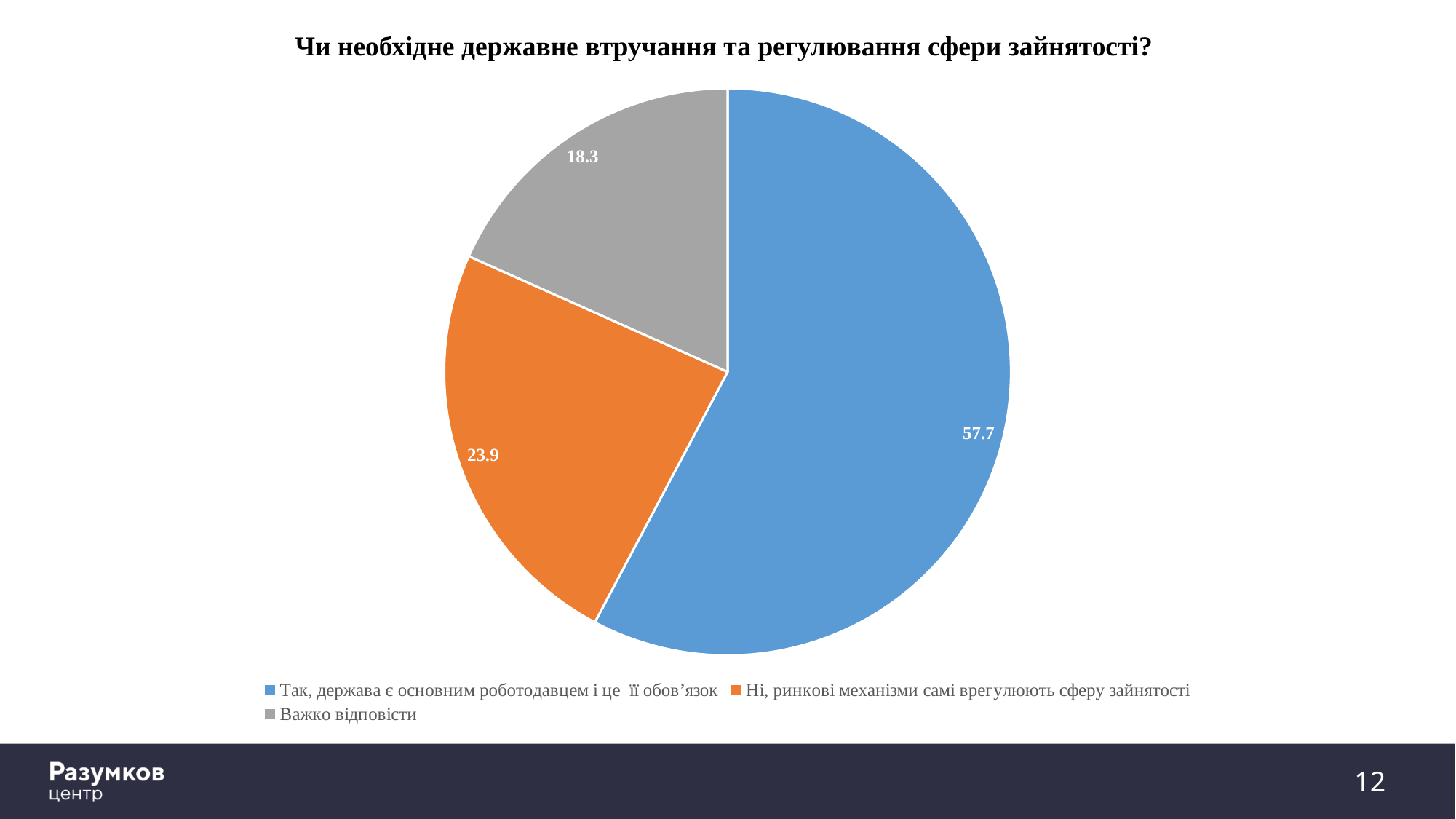
What is the title of the chart? Чи необхідне державне втручання та регулювання сфери зайнятості? Which category has the largest slice? Так, держава є основним роботодавцем і це її обов’язок What is the value for "Ні, ринкові механізми самі врегулюють сферу зайнятості"? 23.9 What is the value for "Важко відповісти"? 18.3 Which category has the smallest slice? Важко відповісти What is the difference between the values for "Так, держава є основним роботодавцем і це її обов’язок" and "Ні, ринкові механізми самі врегулюють сферу зайнятості"? 33.8 What type of chart is shown on the slide? pie chart What is the difference between the values for "Ні, ринкові механізми самі врегулюють сферу зайнятості" and "Важко відповісти"? 5.6 How many slices does the pie chart have? 3 Which is larger: the value for "Ні, ринкові механізми самі врегулюють сферу зайнятості" or for "Важко відповісти"? Ні, ринкові механізми самі врегулюють сферу зайнятості What colour is the slice for "Важко відповісти"? grey What is the value for "Так, держава є основним роботодавцем і це її обов’язок"? 57.7